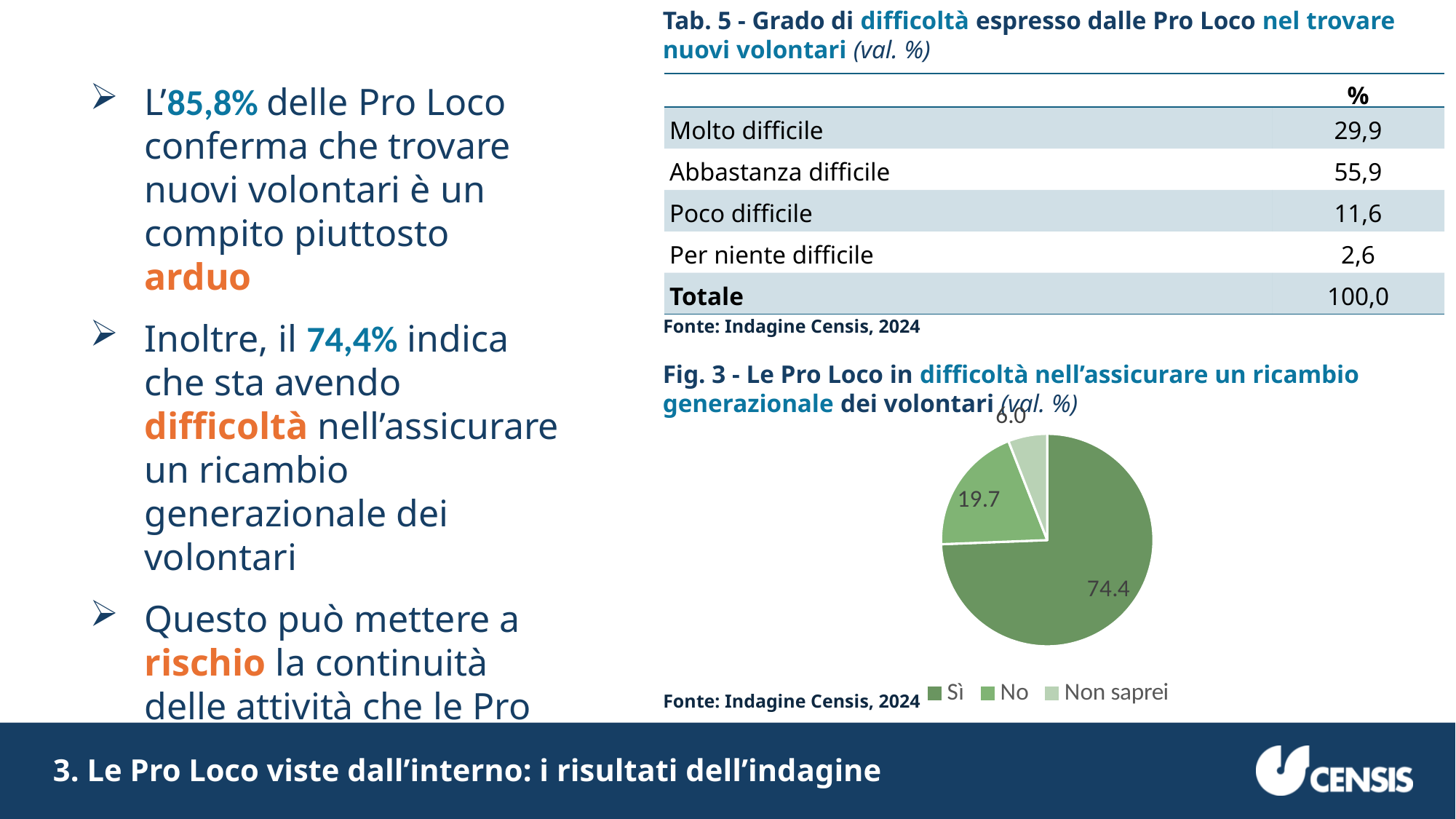
In Fig. 3, what share of Pro Loco answered "No"? 19.7 What type of chart is Fig. 3? Pie chart What is the source cited below Fig. 3? Indagine Censis, 2024 In Fig. 3, what share of Pro Loco answered "Non saprei"? 6.0 In Fig. 3, what is the combined share of "No" and "Non saprei"? 25.7 In Fig. 3, which response has the largest slice of the pie? Sì In Fig. 3, what share of Pro Loco answered "Sì"? 74.4 In Fig. 3, what is the difference between the "Sì" and "No" shares? 54.7 In Fig. 3, which response has the smallest slice of the pie? Non saprei In Fig. 3, how many entries does the legend list? 3 In Fig. 3, how many slices does the pie chart have? 3 In Fig. 3, which is larger: the "No" slice or the "Non saprei" slice? No